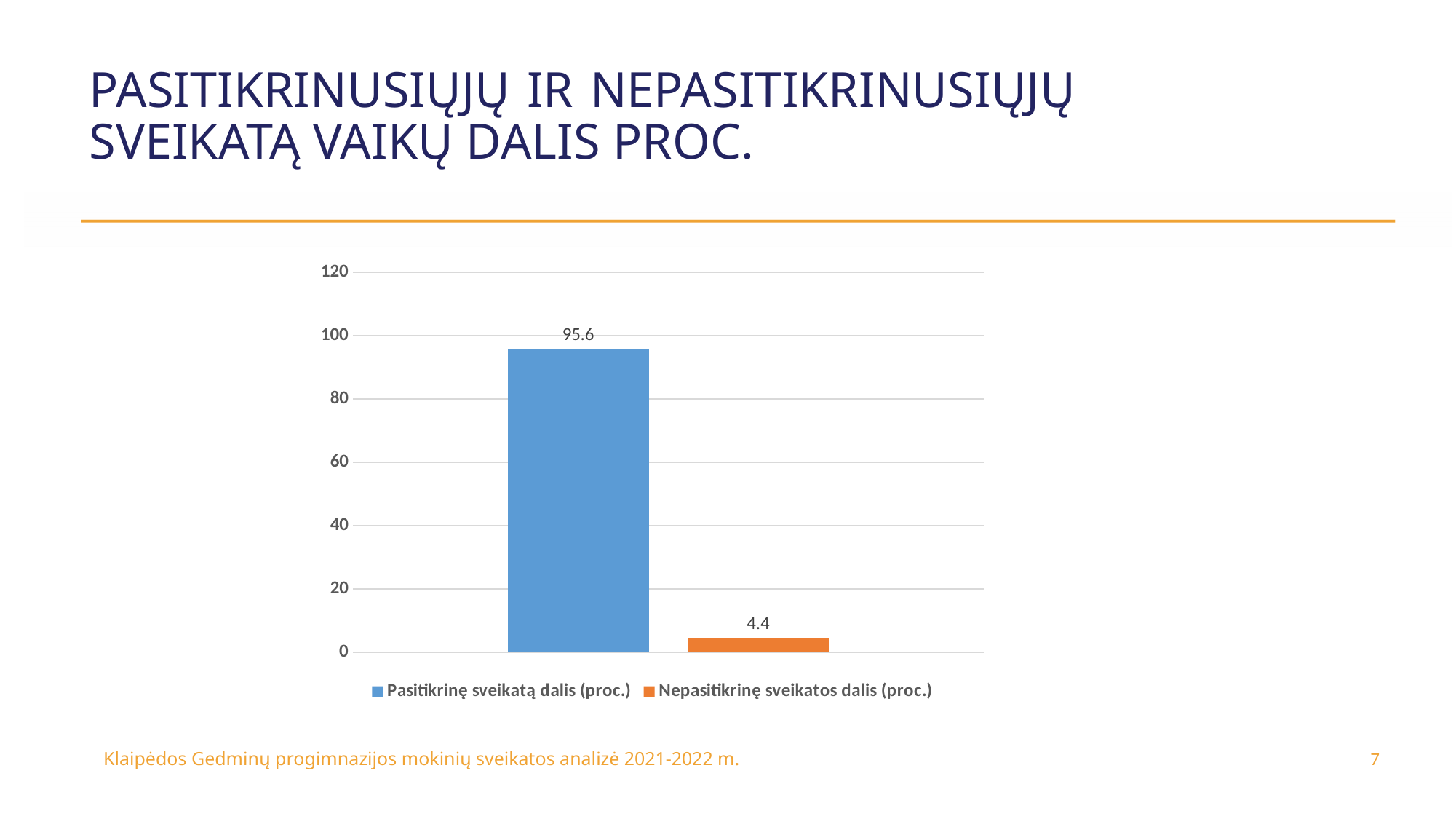
What is the difference between the values for Pasitikrinę sveikatą dalis (proc.) and Nepasitikrinę sveikatos dalis (proc.)? 91.2 What is the value for Pasitikrinę sveikatą dalis (proc.)? 95.6 Which is larger: Pasitikrinę sveikatą dalis (proc.) or Nepasitikrinę sveikatos dalis (proc.)? Pasitikrinę sveikatą dalis (proc.) Which series has the lowest value? Nepasitikrinę sveikatos dalis (proc.) How many series does the legend list? 2 Is the value for Nepasitikrinę sveikatos dalis (proc.) greater or less than 20? less What is the total of the two plotted values? 100 Is the value for Pasitikrinę sveikatą dalis (proc.) greater or less than 80? greater Which series has the highest value? Pasitikrinę sveikatą dalis (proc.) What kind of chart is shown on the slide? Bar chart What is the value for Nepasitikrinę sveikatos dalis (proc.)? 4.4 What colour is the bar for Nepasitikrinę sveikatos dalis (proc.)? Orange